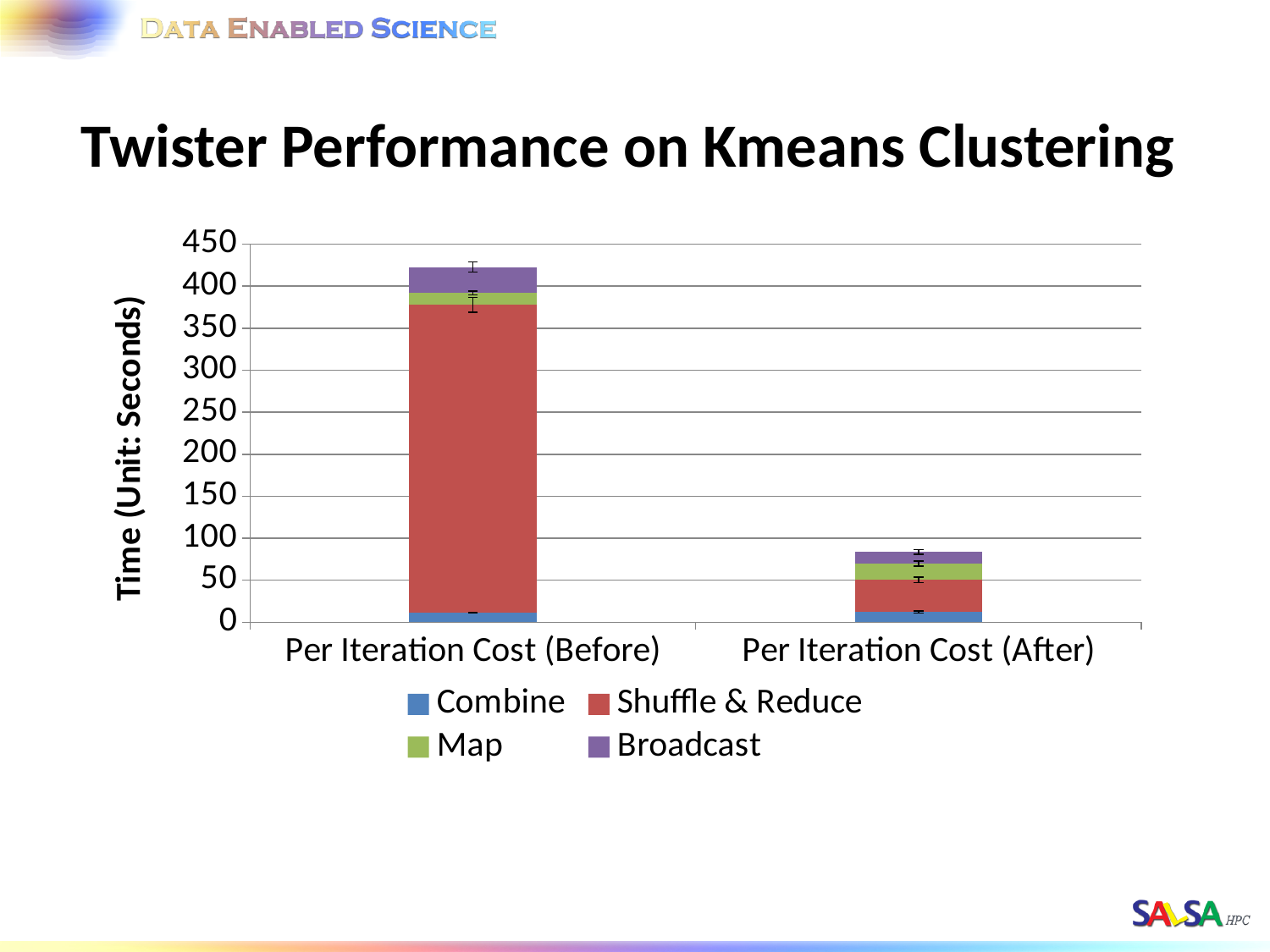
What is the title of the y axis? Time (Unit: Seconds) Which series is shown in red? Shuffle & Reduce Is the total value for Per Iteration Cost (Before) greater or less than 400? greater Is the Shuffle & Reduce segment for Per Iteration Cost (Before) greater or less than 300? greater Which category has the taller stacked bar, Per Iteration Cost (Before) or Per Iteration Cost (After)? Per Iteration Cost (Before) What kind of chart is shown on the slide? Stacked bar chart Do the total values rise or fall from Per Iteration Cost (Before) to Per Iteration Cost (After)? fall How many categories are shown on the x axis? 2 Which category has the lowest total time? Per Iteration Cost (After) Is the Combine segment for Per Iteration Cost (Before) greater or less than 50? less How many series does the legend list? 4